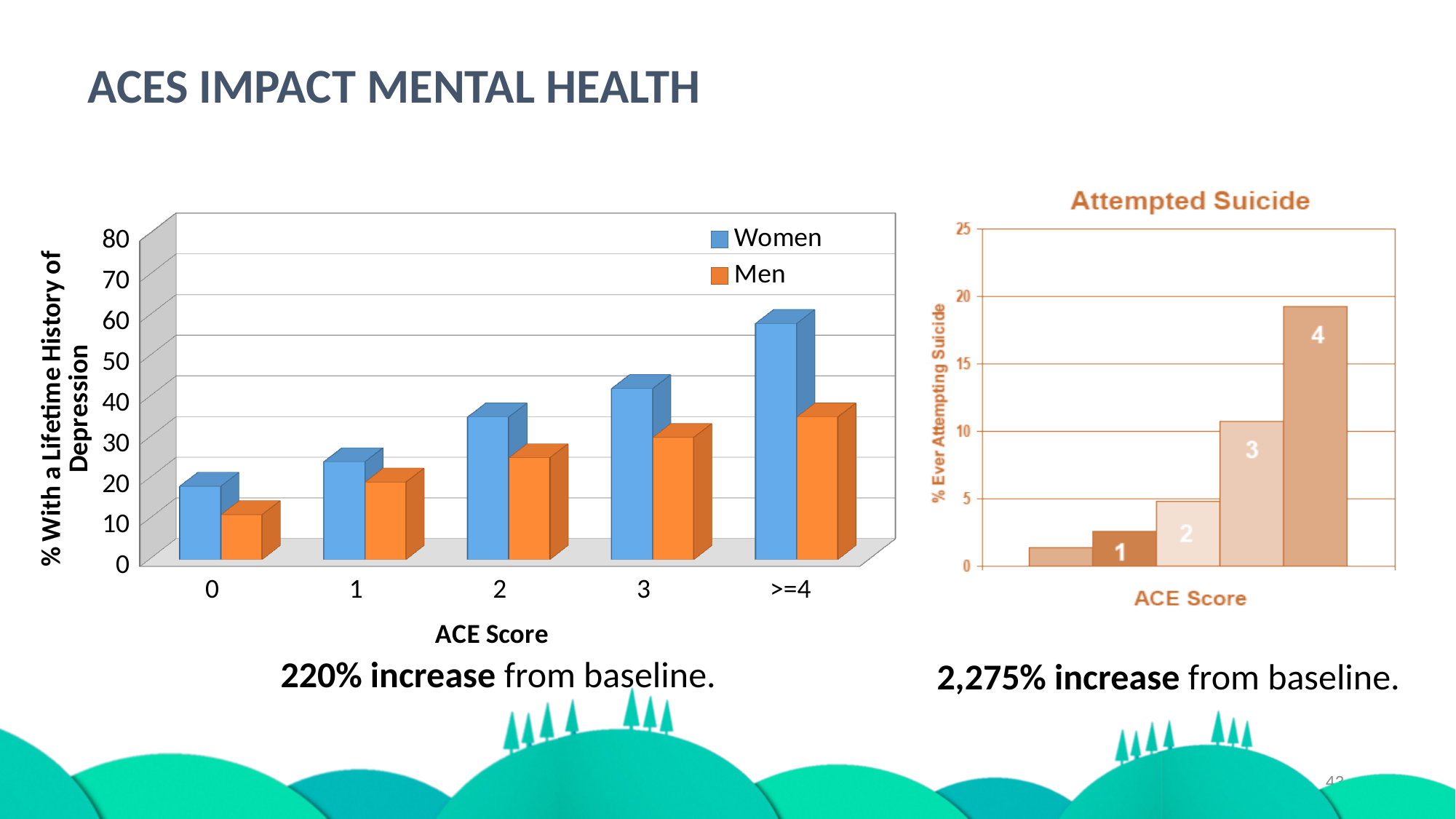
What is the title of the chart on the right? Attempted Suicide On the left chart, what are the two series named in the legend? Women and Men On the Attempted Suicide chart, which ACE Score has the highest percentage ever attempting suicide? 4 On the left chart, is the value for Women at ACE Score >=4 greater or less than 50? greater What kind of chart is the Attempted Suicide chart? bar chart On the left chart, at ACE Score >=4, which is larger, the value for Women or for Men? Women On the left chart, is the value for Men at ACE Score 0 greater or less than 20? less On the Attempted Suicide chart, is the value for ACE Score 4 greater or less than 15? greater On the left chart, do the values for Women rise or fall as the ACE Score increases? rise On the left chart, how many series does the legend list? 2 On the left chart, how many ACE Score categories are shown on the x axis? 5 On the left chart, which ACE Score category has the highest value for Women? >=4